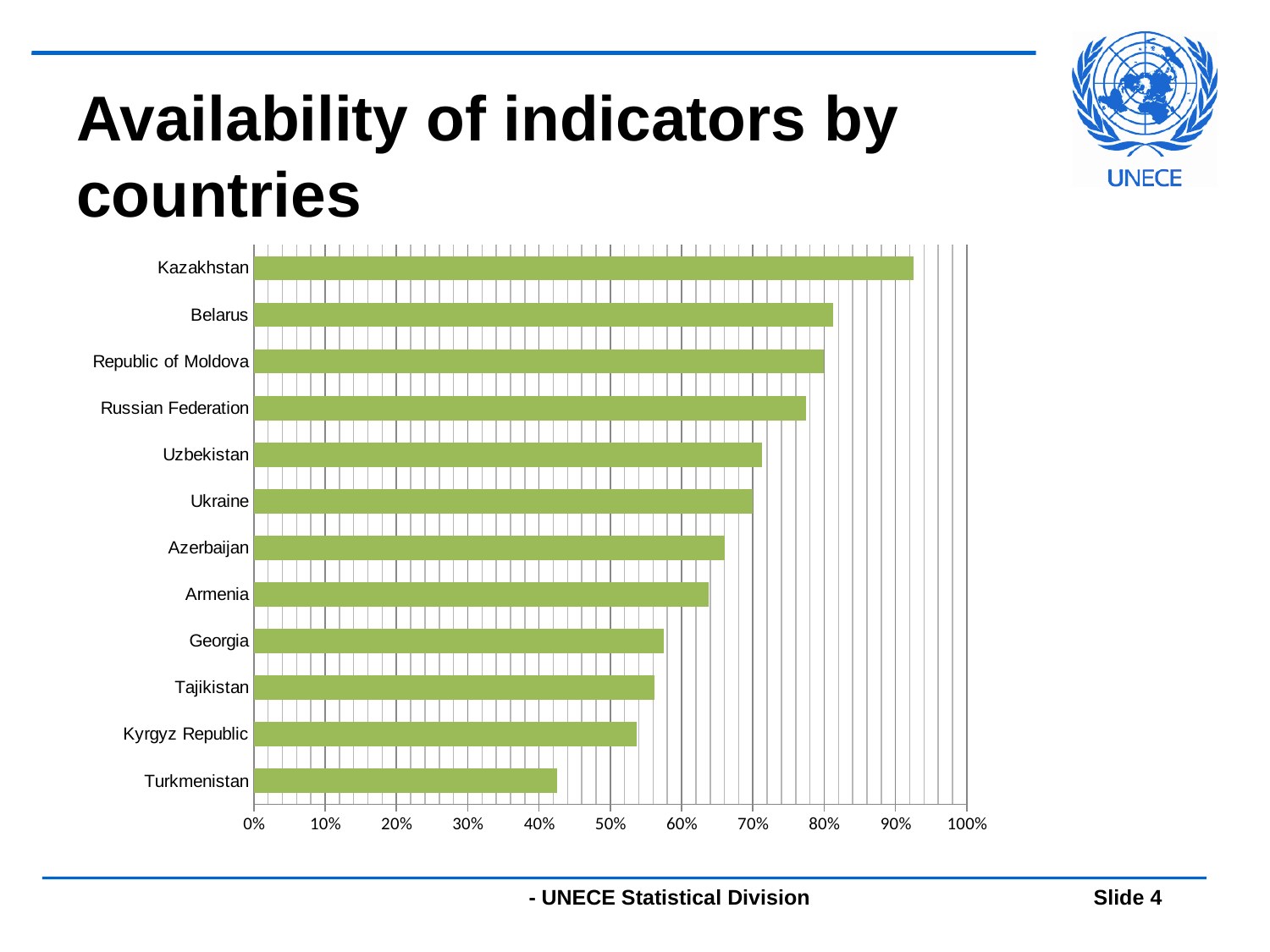
What is the title of the slide containing the chart? Availability of indicators by countries Which country has the lowest availability of indicators? Turkmenistan Is the value for Armenia greater or less than 60%? greater Is the value for Kazakhstan greater or less than 90%? greater What kind of chart is shown on the slide? bar chart Is the value for Kyrgyz Republic greater or less than 60%? less Which has a higher value, Belarus or Georgia? Belarus Which country has the highest availability of indicators? Kazakhstan Which has a lower value, Ukraine or Tajikistan? Tajikistan How many countries are shown in the chart? 12